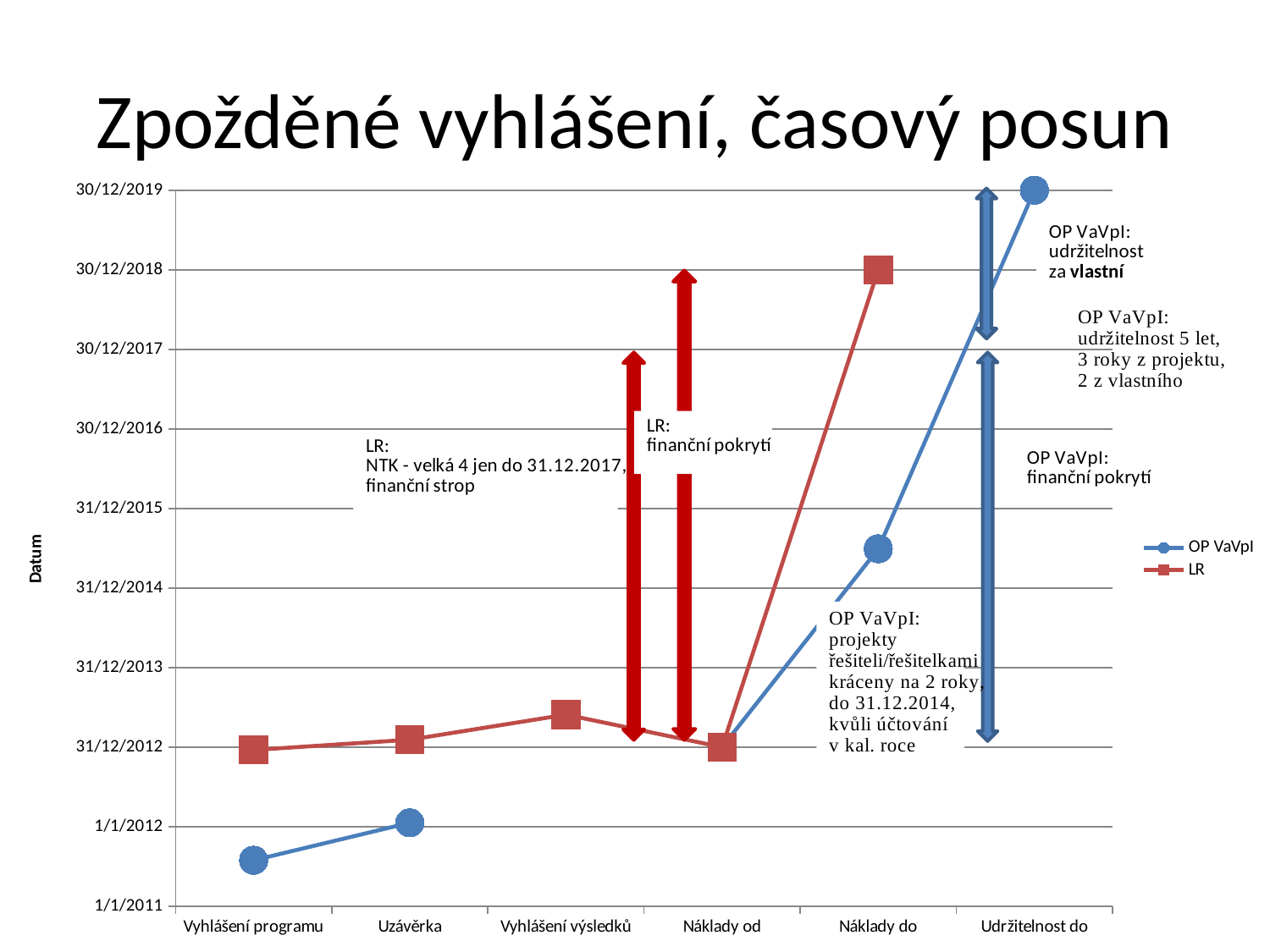
Which series is drawn with square markers? LR What date does the OP VaVpI series reach at Udržitelnost do? 30/12/2019 What kind of chart is shown on the slide? line chart At Uzávěrka, which series has the later date, OP VaVpI or LR? LR For which category does the OP VaVpI series reach its latest date? Udržitelnost do For which category does the OP VaVpI series have its earliest date? Vyhlášení programu What is the title of the slide containing the chart? Zpožděné vyhlášení, časový posun How many categories are shown on the x axis? 6 Is the OP VaVpI value at Náklady do later or earlier than 31/12/2014? later For which category does the LR series reach its latest date? Náklady do What date does the LR series reach at Náklady do? 30/12/2018 How many series does the legend list? 2